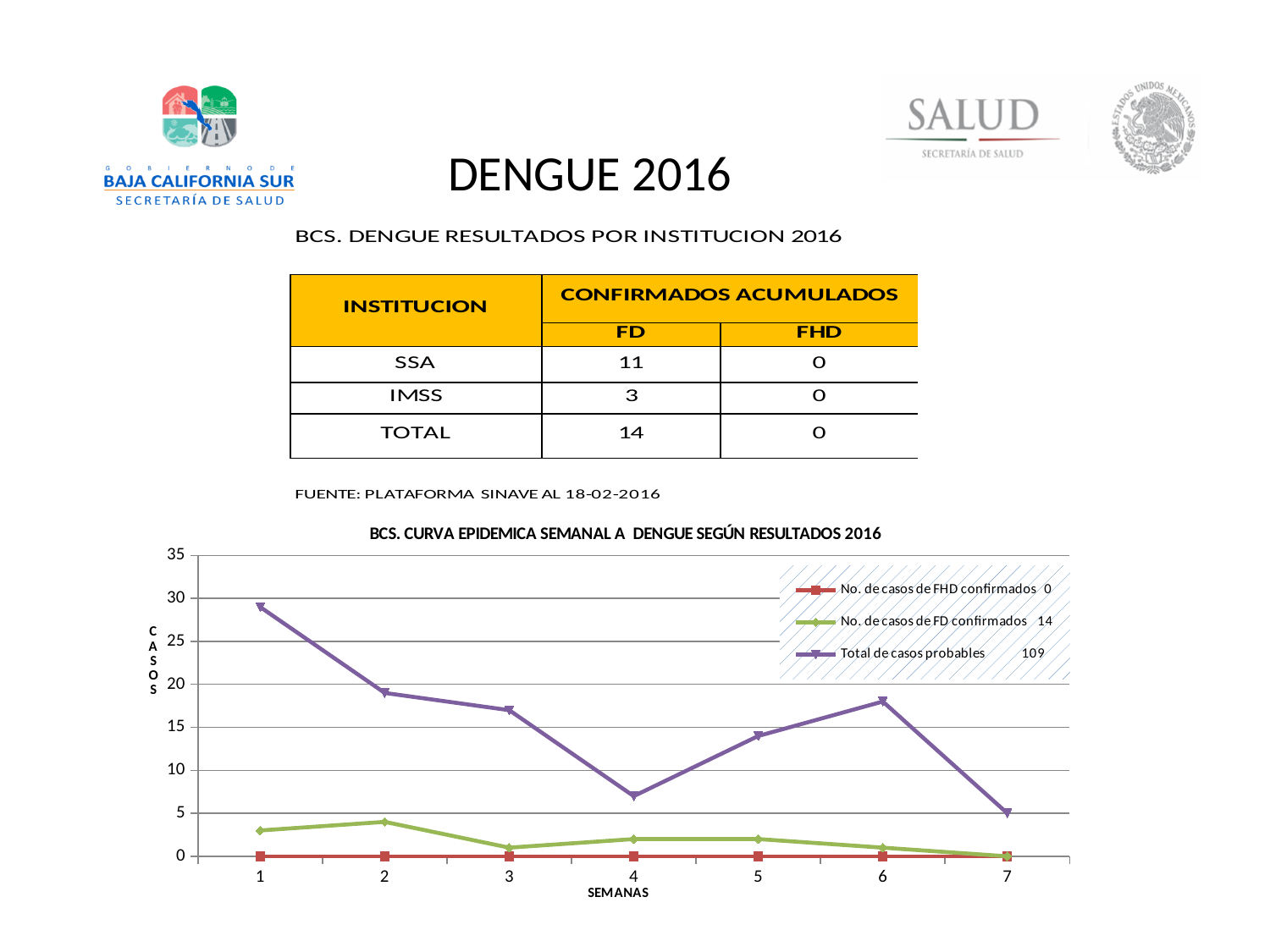
Is the value for 'Total de casos probables' in week 4 greater or less than 10? less What kind of chart is shown on the slide? line chart How many series does the legend of the chart list? 3 What total is shown in the legend next to 'No. de casos de FD confirmados'? 14 What total is shown in the legend next to 'Total de casos probables'? 109 Does the value for 'Total de casos probables' rise or fall from week 1 to week 4? fall Is the value for 'Total de casos probables' in week 1 greater or less than 25? greater How many weeks (semanas) are plotted along the x axis of the chart? 7 In which week is the value for 'Total de casos probables' highest? 1 In which week is the value for 'Total de casos probables' lowest? 7 Which is larger, the value for 'Total de casos probables' in week 6 or in week 5? week 6 What is the value for 'No. de casos de FHD confirmados' in week 3? 0